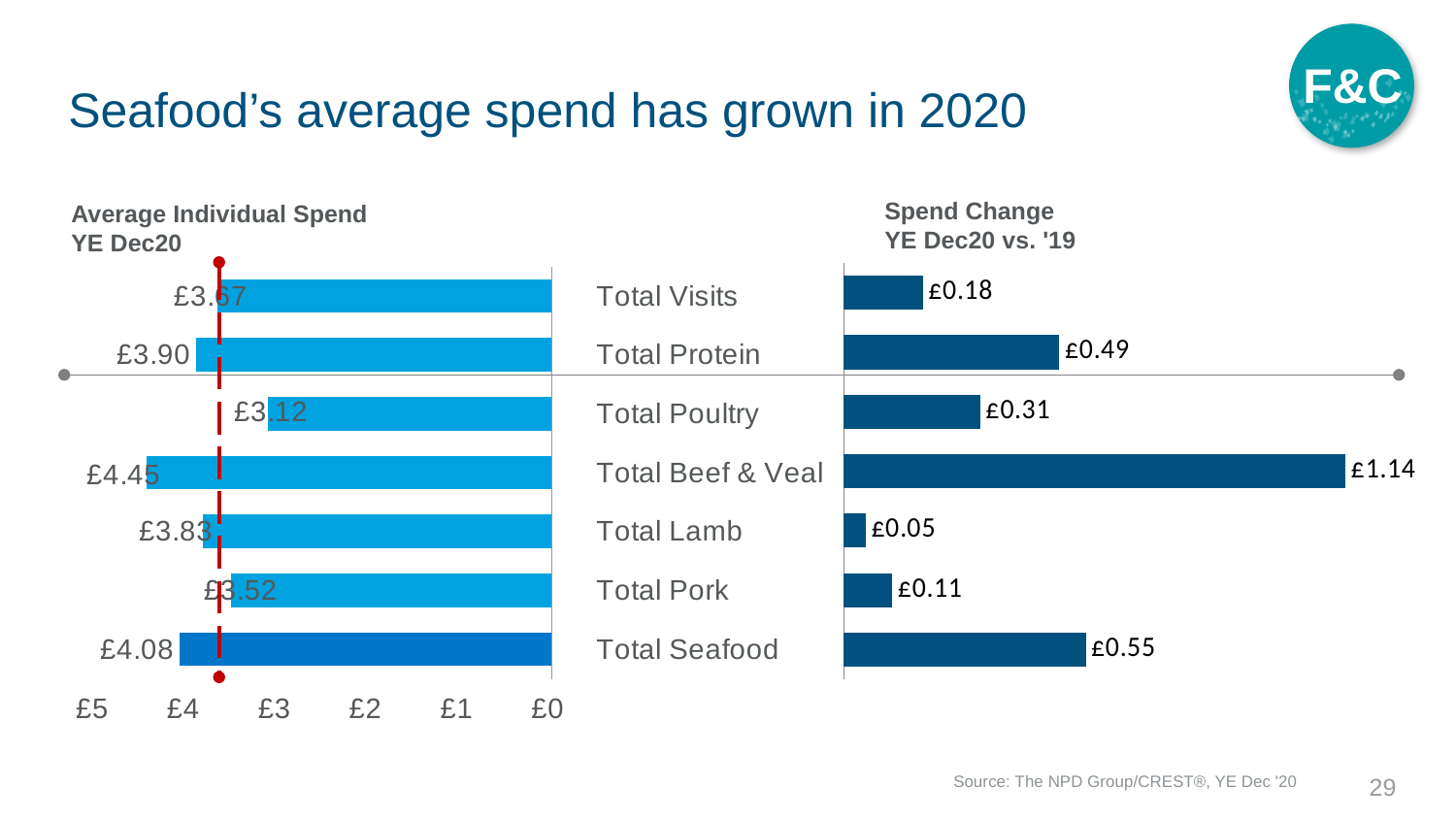
In the Average Individual Spend chart, is the value for Total Pork greater or less than £4? less How many categories are shown in the Spend Change chart? 7 In the Average Individual Spend chart, what is the value for Total Beef & Veal? £4.45 In the Spend Change chart, what is the difference between Total Beef & Veal and Total Seafood? £0.59 In the Spend Change chart, what is the value for Total Lamb? £0.05 What kind of chart is the Average Individual Spend chart? Bar chart In the Average Individual Spend chart, which is larger, Total Seafood or Total Protein? Total Seafood In the Average Individual Spend chart, which category has the highest value? Total Beef & Veal In the Average Individual Spend chart, which category has the lowest value? Total Poultry In the Spend Change chart, what is the value for Total Seafood? £0.55 In the Spend Change chart, which category has the lowest value? Total Lamb In the Average Individual Spend chart, what is the value for Total Seafood? £4.08